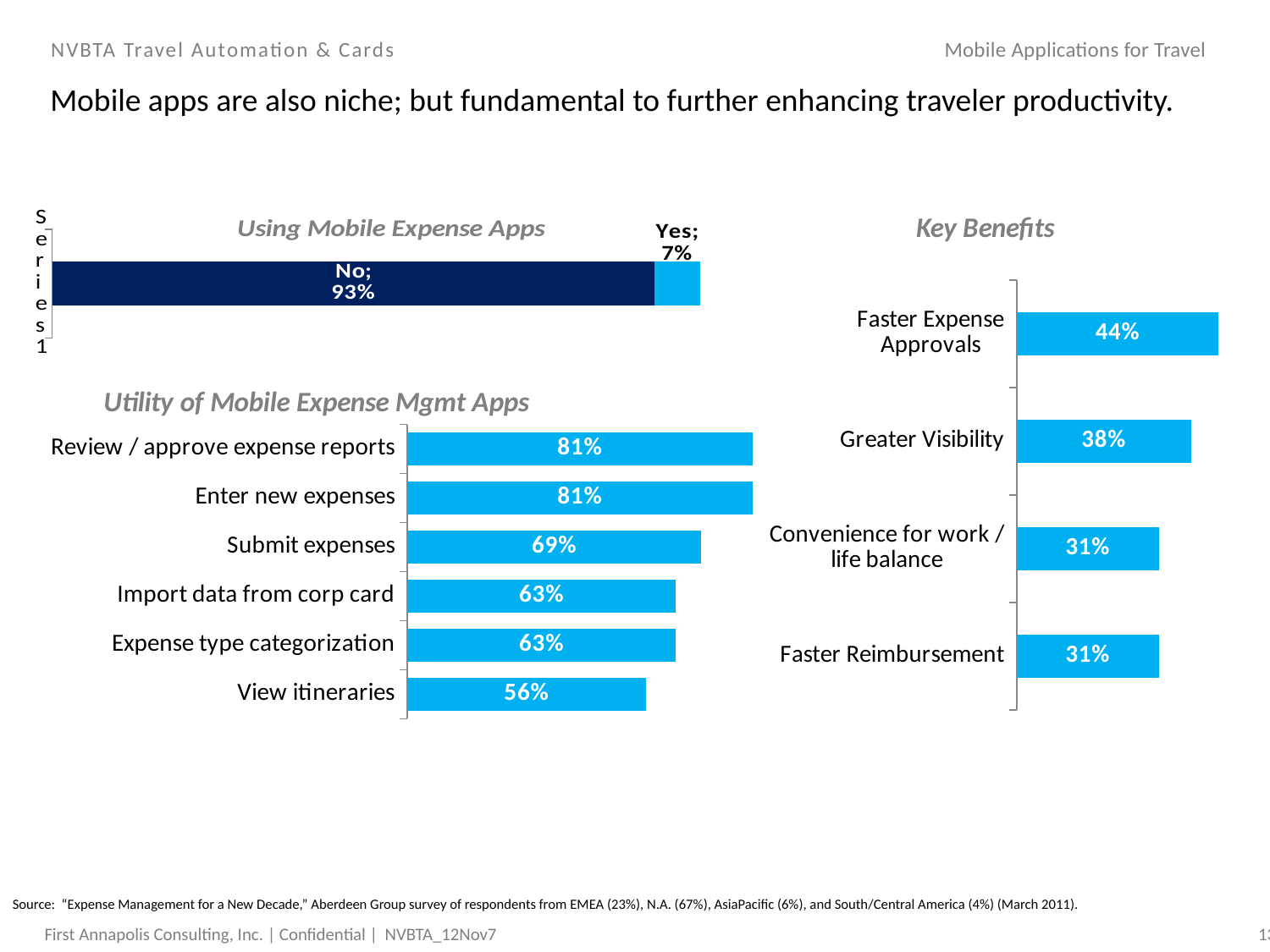
In the 'Utility of Mobile Expense Mgmt Apps' chart, which is larger: Submit expenses or Import data from corp card? Submit expenses In the 'Using Mobile Expense Apps' chart, what is the total of the No and Yes segments? 100% How many categories are shown in the 'Utility of Mobile Expense Mgmt Apps' chart? 6 In the 'Utility of Mobile Expense Mgmt Apps' chart, which category has the lowest value? View itineraries How many categories are shown in the 'Key Benefits' chart? 4 In the 'Utility of Mobile Expense Mgmt Apps' chart, what is the value for Submit expenses? 69% In the 'Using Mobile Expense Apps' chart, what percentage of respondents answered No? 93% In the 'Key Benefits' chart, what is the value for Greater Visibility? 38% What type of chart is the 'Key Benefits' chart? Bar chart In the 'Utility of Mobile Expense Mgmt Apps' chart, what is the value for View itineraries? 56% In the 'Key Benefits' chart, what is the difference between Faster Expense Approvals and Faster Reimbursement? 13% In the 'Key Benefits' chart, which category has the highest value? Faster Expense Approvals